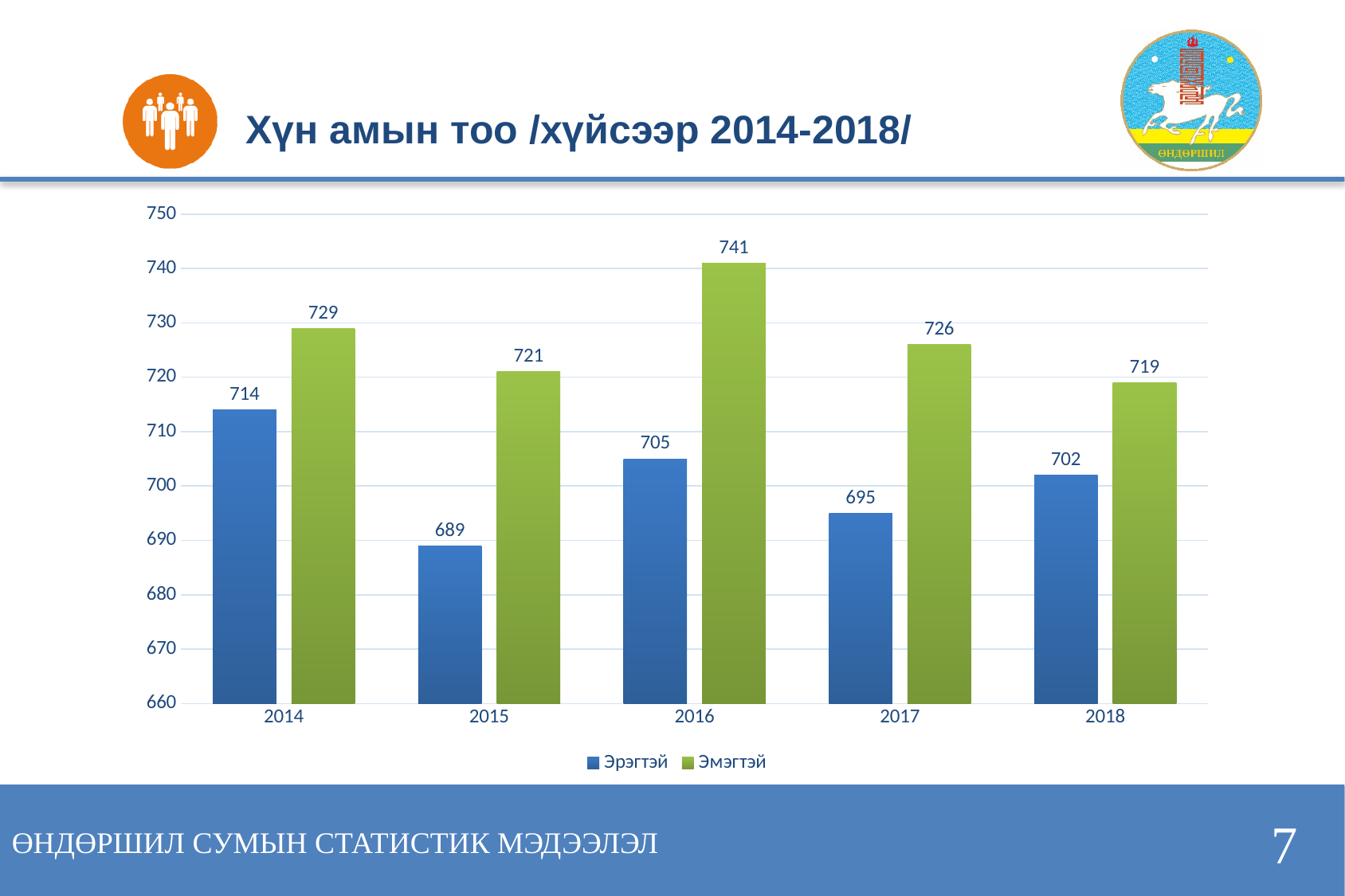
What is the value for Эмэгтэй in 2018? 719 Is the Эрэгтэй value for 2018 greater or less than 700? greater How many series does the legend list? 2 What kind of chart is shown on the slide? bar chart Which is larger in 2017: the Эрэгтэй value or the Эмэгтэй value? Эмэгтэй In which year is the Эрэгтэй value lowest? 2015 What is the value for Эрэгтэй in 2016? 705 In which year is the Эмэгтэй value highest? 2016 What is the difference between the Эмэгтэй and Эрэгтэй values in 2015? 32 What is the title of the chart? Хүн амын тоо /хүйсээр 2014-2018/ Does the Эрэгтэй value rise or fall from 2015 to 2016? rise How many years are shown on the x axis? 5